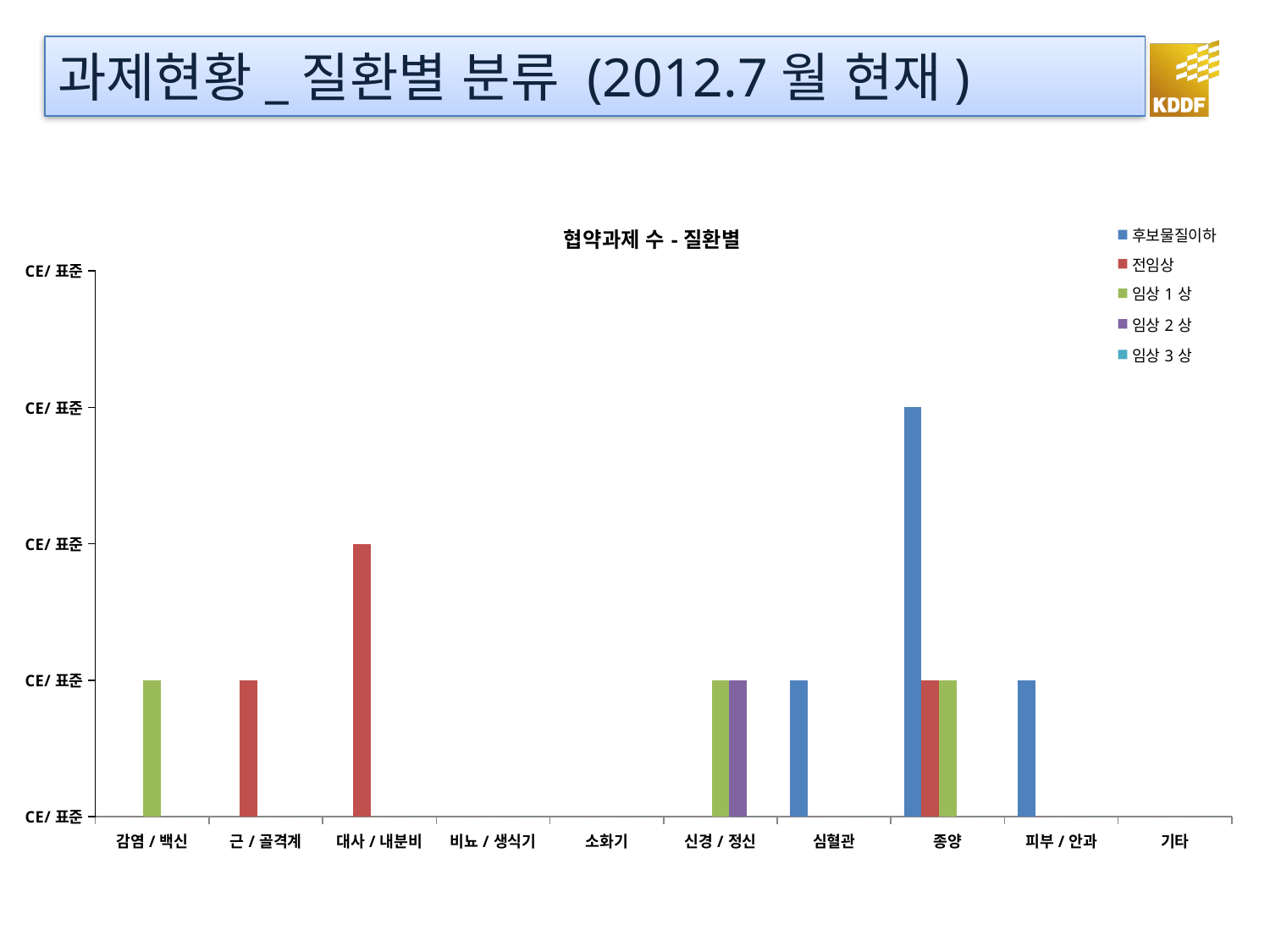
Which series are plotted for the 신경 / 정신 category? 임상 1 상 and 임상 2 상 What is the title of the chart? 협약과제 수 - 질환별 Which is larger, the 전임상 bar for 대사 / 내분비 or the 전임상 bar for 근 / 골격계? 대사 / 내분비 Which is larger, the 후보물질이하 bar for 종양 or the 후보물질이하 bar for 심혈관? 종양 Which series has the tallest bar in the 종양 category? 후보물질이하 How many series does the legend list? 5 Which category has the tallest bar in the chart? 종양 Which is larger, the 전임상 bar for 대사 / 내분비 or the 전임상 bar for 종양? 대사 / 내분비 Which series is the only one plotted for 감염 / 백신? 임상 1 상 How many categories are shown on the x axis? 10 What kind of chart is shown on the slide? Bar chart Which categories have no bars at all? 비뇨 / 생식기, 소화기, 기타